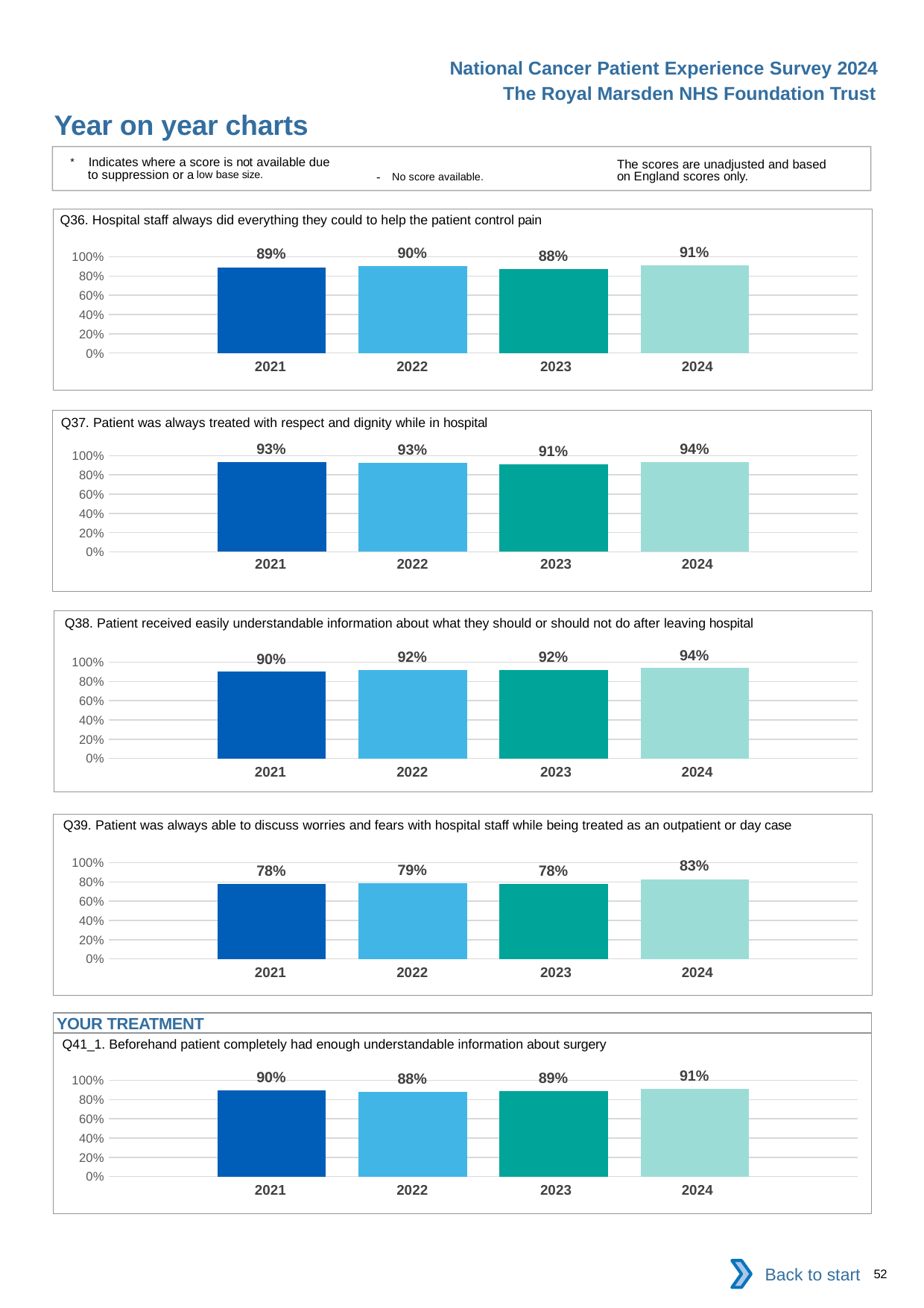
What type of chart is used for Q39? Bar chart In the Q39 chart, which is larger, the value for 2022 or the value for 2024? 2024 In the Q39 chart (able to discuss worries and fears with hospital staff as an outpatient or day case), what is the value for 2024? 83% How many years are shown on the x axis of the Q36 chart? 4 In the Q36 chart, which year has the lowest value? 2023 In the Q37 chart (patient was always treated with respect and dignity while in hospital), what is the value for 2023? 91% In the Q37 chart, which year has the highest value? 2024 In the Q41_1 chart, what is the difference between the 2024 and 2022 values? 3 percentage points In the Q38 chart (easily understandable information about what to do after leaving hospital), what is the difference between the 2024 and 2021 values? 4 percentage points In the Q41_1 chart (enough understandable information about surgery beforehand), what is the value for 2022? 88% In the Q38 chart, what is the value for 2022? 92% In the Q36 chart (hospital staff always did everything they could to help the patient control pain), what is the value for 2024? 91%